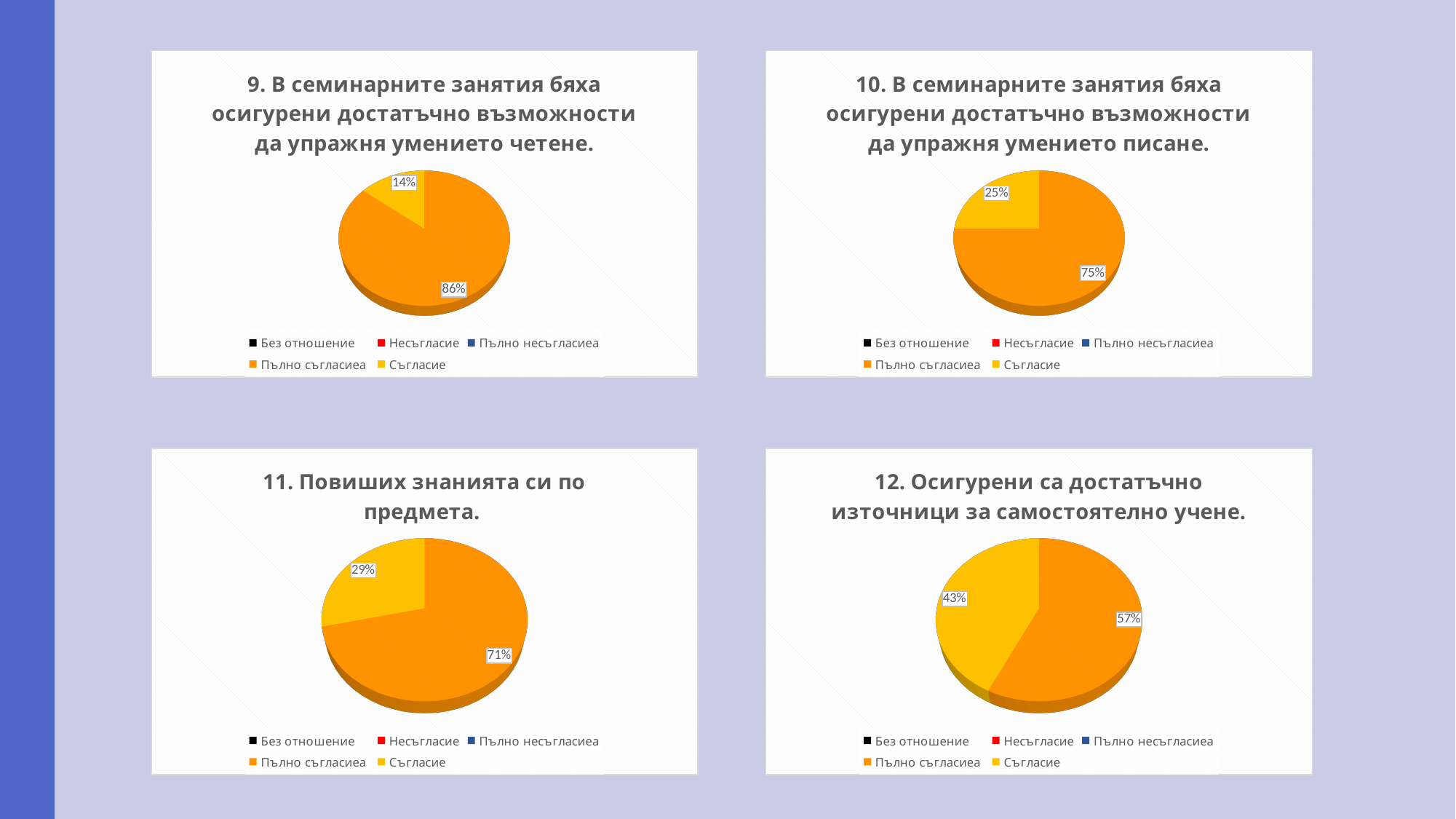
In chart 9 (top left), what percentage is shown for the "Съгласие" slice? 14% What type of chart is used for chart 9 (top left)? Pie chart In chart 11 (bottom left), what percentage is shown for the "Съгласие" slice? 29% In chart 12 (bottom right), what is the difference between the two labelled slices? 14% In chart 12 (bottom right), what percentage is shown for "Пълно съгласиеа"? 57% In chart 10 (top right), what is the difference between the "Пълно съгласиеа" and "Съгласие" slices? 50% In chart 9 (top left), what share of the pie is labelled for "Пълно съгласиеа"? 86% In chart 11 (bottom left), which category has the largest slice? Пълно съгласиеа In chart 11 (bottom left), how many slices have a visible data label? 2 In chart 10 (top right), what percentage is shown for "Пълно съгласиеа"? 75% In chart 12 (bottom right), which is larger, the "Пълно съгласиеа" slice or the "Съгласие" slice? Пълно съгласиеа How many entries does the legend of chart 10 (top right) list? 5